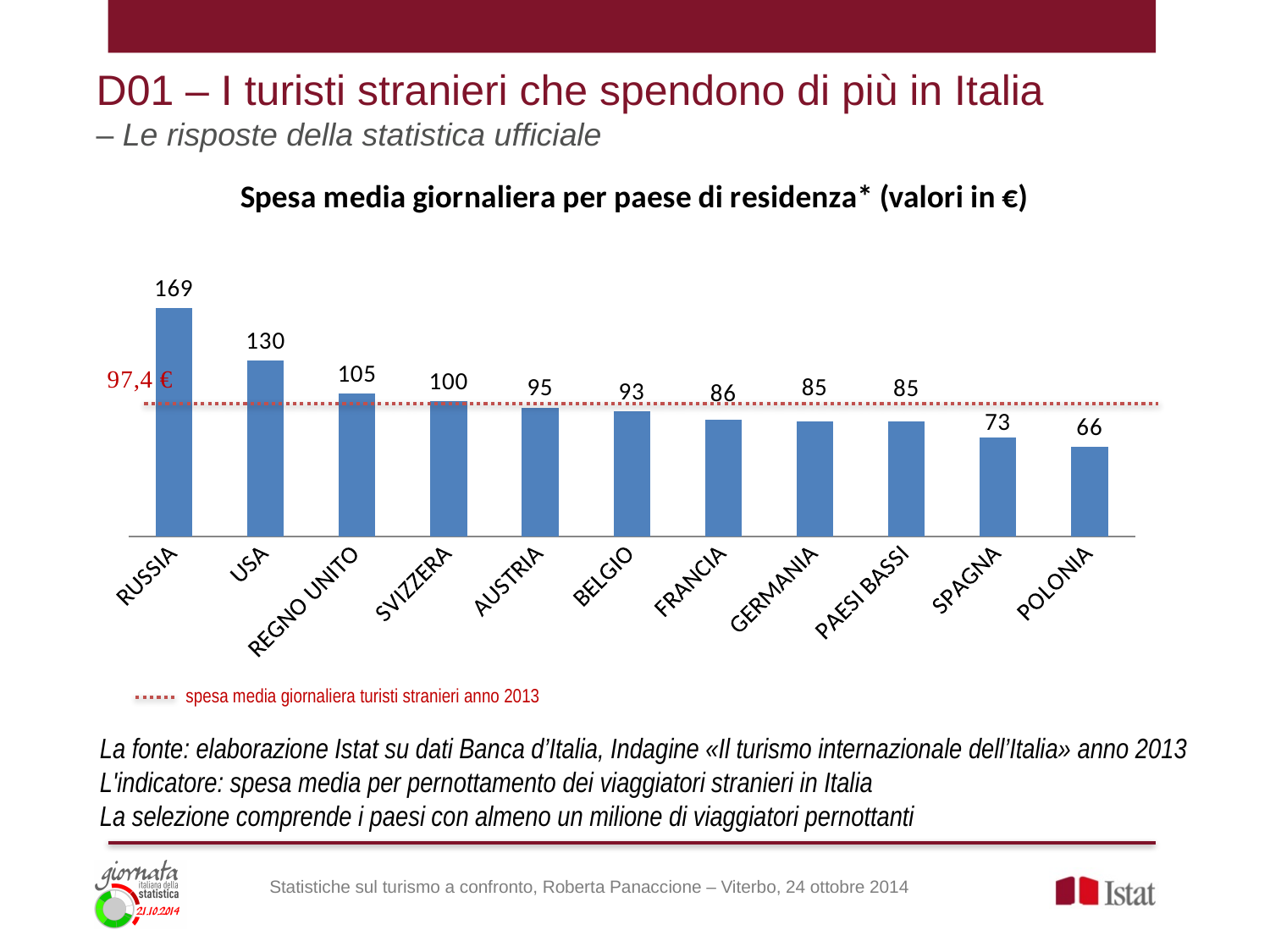
What is the difference between the values for SVIZZERA and SPAGNA? 27 What kind of chart is shown on the slide? Bar chart How many countries are shown in the chart? 11 Which has a higher value, AUSTRIA or FRANCIA? AUSTRIA What is the average daily spending value shown for RUSSIA? 169 What value does the dotted horizontal line represent? 97,4 € What is the difference between the values for RUSSIA and USA? 39 Do the values rise or fall from left to right along the x axis? Fall Which country has the lowest average daily spending? POLONIA What is the value shown for REGNO UNITO? 105 Which country has the highest average daily spending? RUSSIA What is the value shown for POLONIA? 66